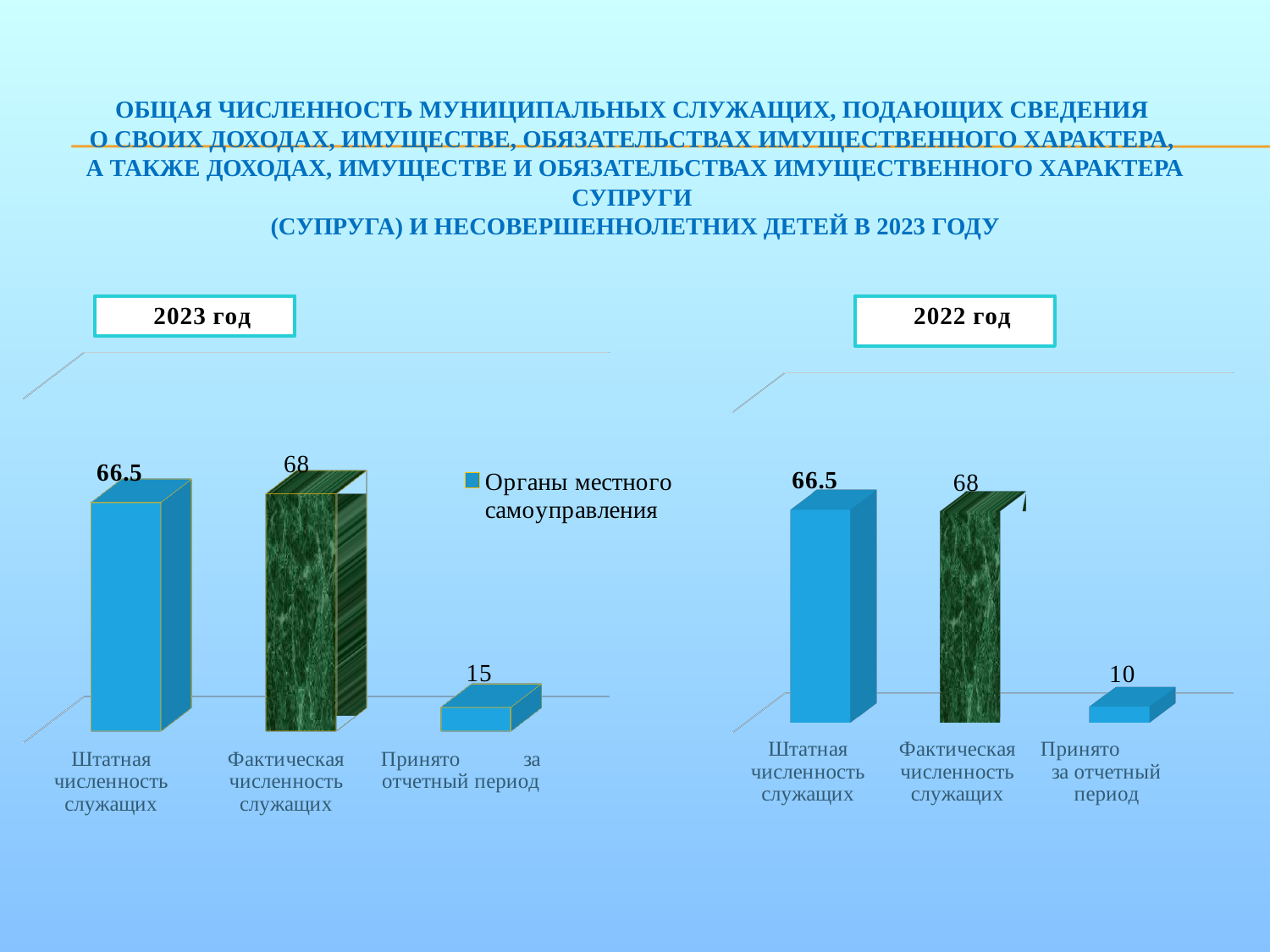
In the 2023 год chart, what is the difference between Фактическая численность служащих and Штатная численность служащих? 1.5 What is the difference between the Принято за отчетный период value in the 2023 год chart and in the 2022 год chart? 5 In the 2022 год chart, what is the value for Фактическая численность служащих? 68 In the 2023 год chart, what is the value for Принято за отчетный период? 15 How many categories are shown in the 2023 год chart? 3 How many series does the legend of the 2023 год chart list? 1 In the 2022 год chart, which is larger: Штатная численность служащих or Принято за отчетный период? Штатная численность служащих In the 2023 год chart, which category has the lowest value? Принято за отчетный период In the 2023 год chart, what is the value for Штатная численность служащих? 66.5 What type of chart is the 2022 год chart? Bar chart In the 2022 год chart, what is the value for Принято за отчетный период? 10